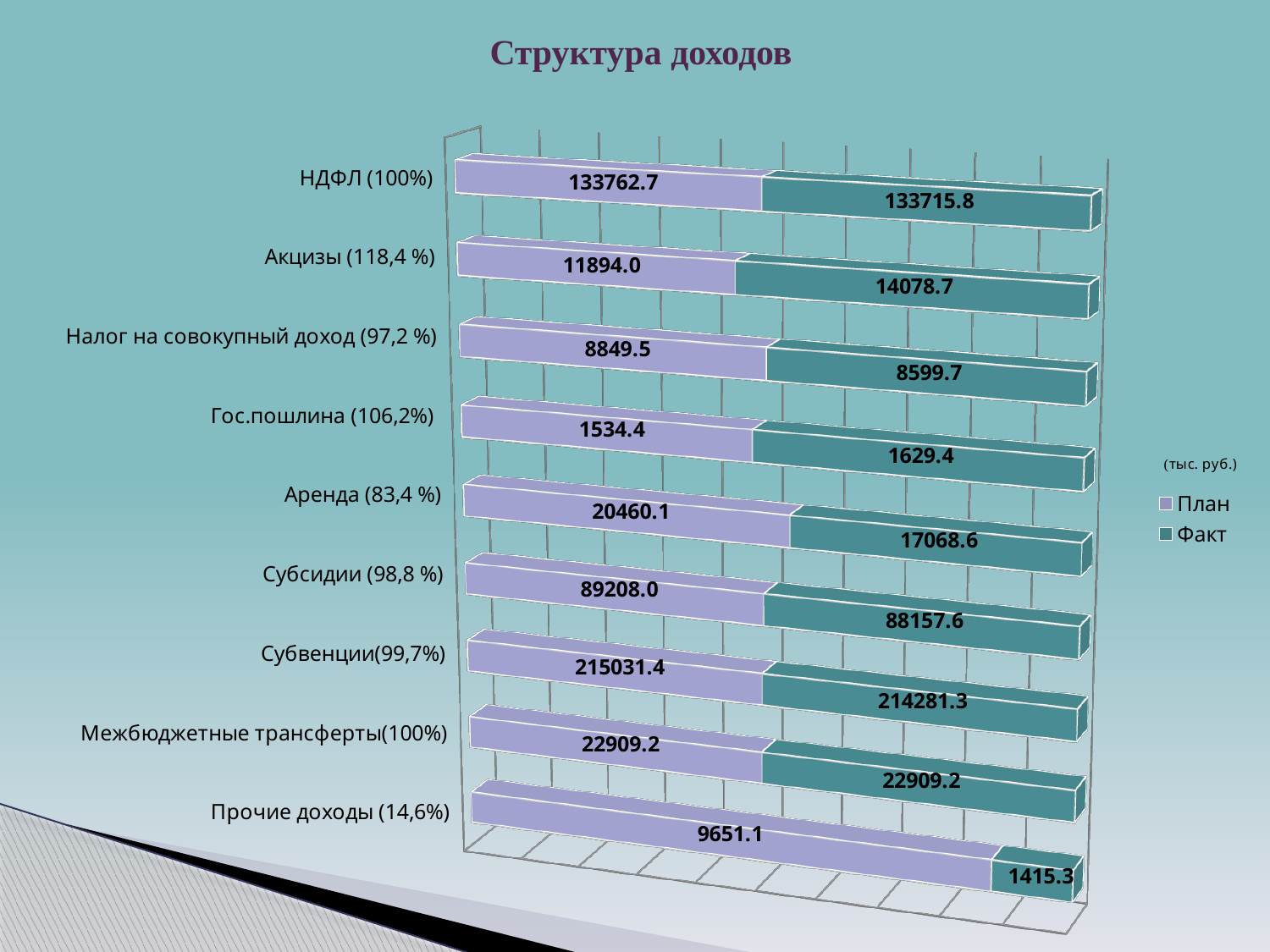
What is the План value for НДФЛ (100%)? 133762.7 What is the Факт value for Акцизы (118,4 %)? 14078.7 By how much does the Факт value exceed the План value for Акцизы (118,4 %)? 2184.7 For Гос.пошлина (106,2%), which is larger: План or Факт? Факт What is the Факт value for Прочие доходы (14,6%)? 1415.3 What is the difference between the План and Факт values for Аренда (83,4 %)? 3391.5 What kind of chart is shown on the slide? Bar chart Which category has the highest План value? Субвенции(99,7%) Which category has the lowest Факт value? Прочие доходы (14,6%) How many series does the legend list? 2 What is the План value for Субвенции(99,7%)? 215031.4 How many categories are shown in the chart? 9